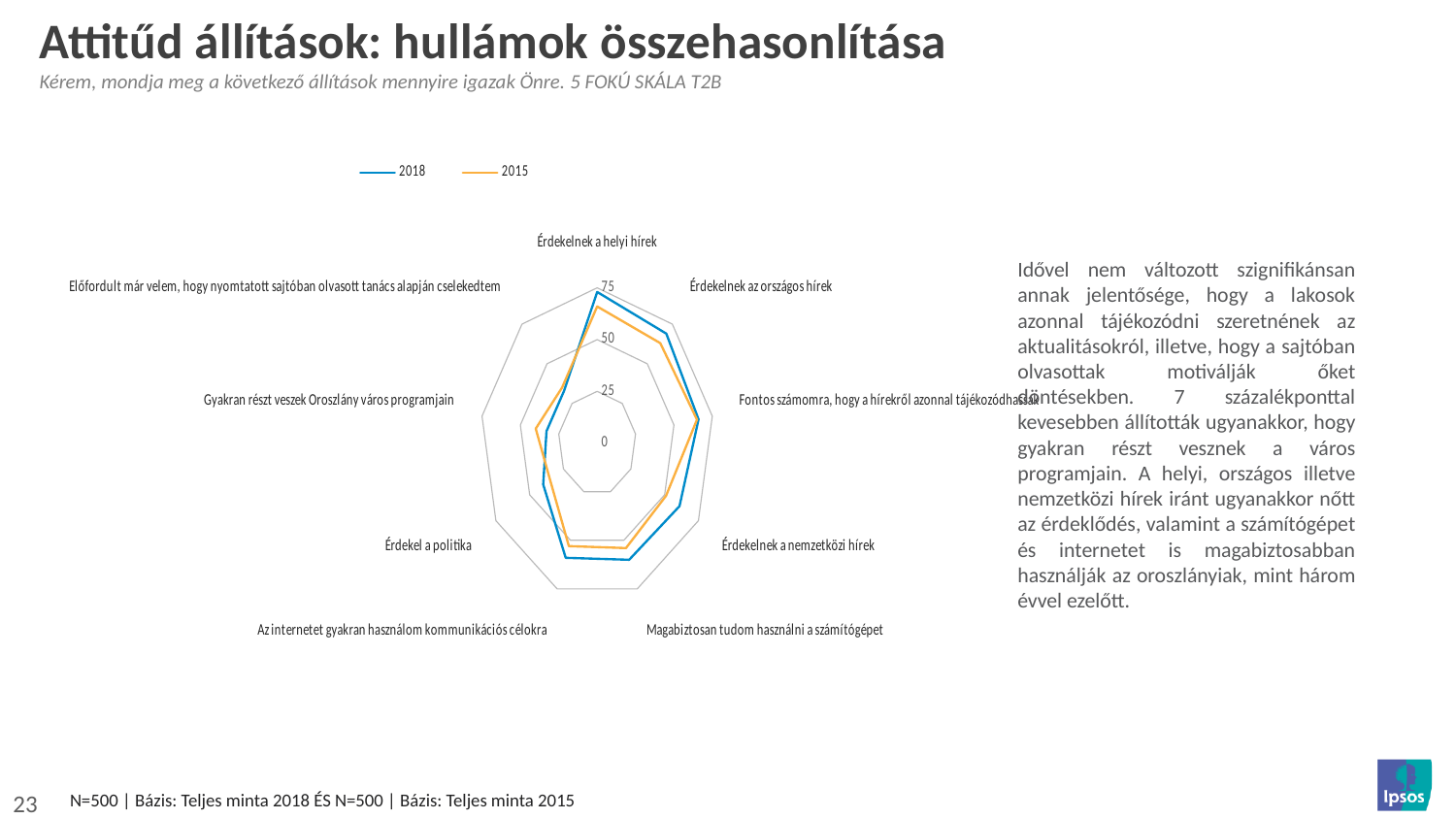
For "Érdekelnek a helyi hírek", which year has the higher value, 2018 or 2015? 2018 What kind of chart is shown on the slide? Radar chart Is the 2015 value for "Fontos számomra, hogy a hírekről azonnal tájékozódhassak" greater or less than 50? greater Is the 2018 value for "Érdekelnek a nemzetközi hírek" greater or less than 50? greater Is the 2015 value for "Érdekelnek a helyi hírek" greater or less than 75? less What is the highest tick value shown on the radar chart's axis? 75 How many series does the chart legend list? 2 How many statements (axes) are plotted on the radar chart? 9 For "Gyakran részt veszek Oroszlány város programjain", which year has the higher value, 2018 or 2015? 2015 Which years are listed in the chart legend? 2018 and 2015